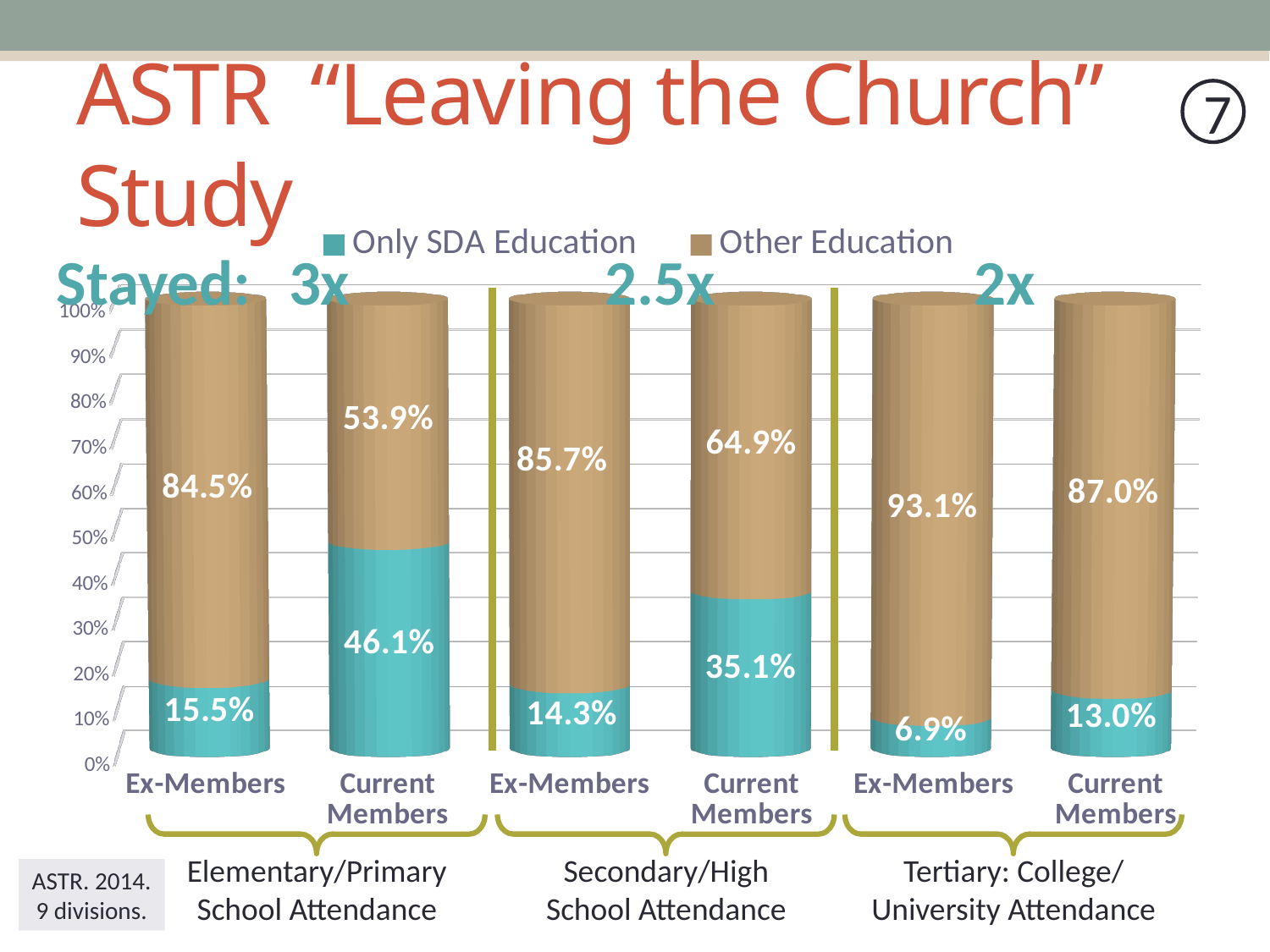
What is the Other Education value for Ex-Members in the Tertiary: College/University Attendance group? 93.1% Which is larger: the Only SDA Education value for Current Members in the Secondary/High School group or for Ex-Members in the same group? Current Members How many series does the legend list? 2 What is the total of the stacked bar for Current Members in the Tertiary: College/University Attendance group? 100% What percentage of Current Members in the Elementary/Primary School Attendance group had Only SDA Education? 46.1% What is the Other Education value for Current Members in the Secondary/High School Attendance group? 64.9% How many bars are plotted in the chart? 6 In the Elementary/Primary School Attendance group, what is the difference in Only SDA Education between Current Members and Ex-Members? 30.6 percentage points Which bar has the lowest Only SDA Education value? Ex-Members (Tertiary: College/University Attendance) What is the Only SDA Education value for Ex-Members in the Secondary/High School Attendance group? 14.3% What kind of chart is shown on the slide? Stacked bar chart Which bar has the highest Only SDA Education value? Current Members (Elementary/Primary School Attendance)